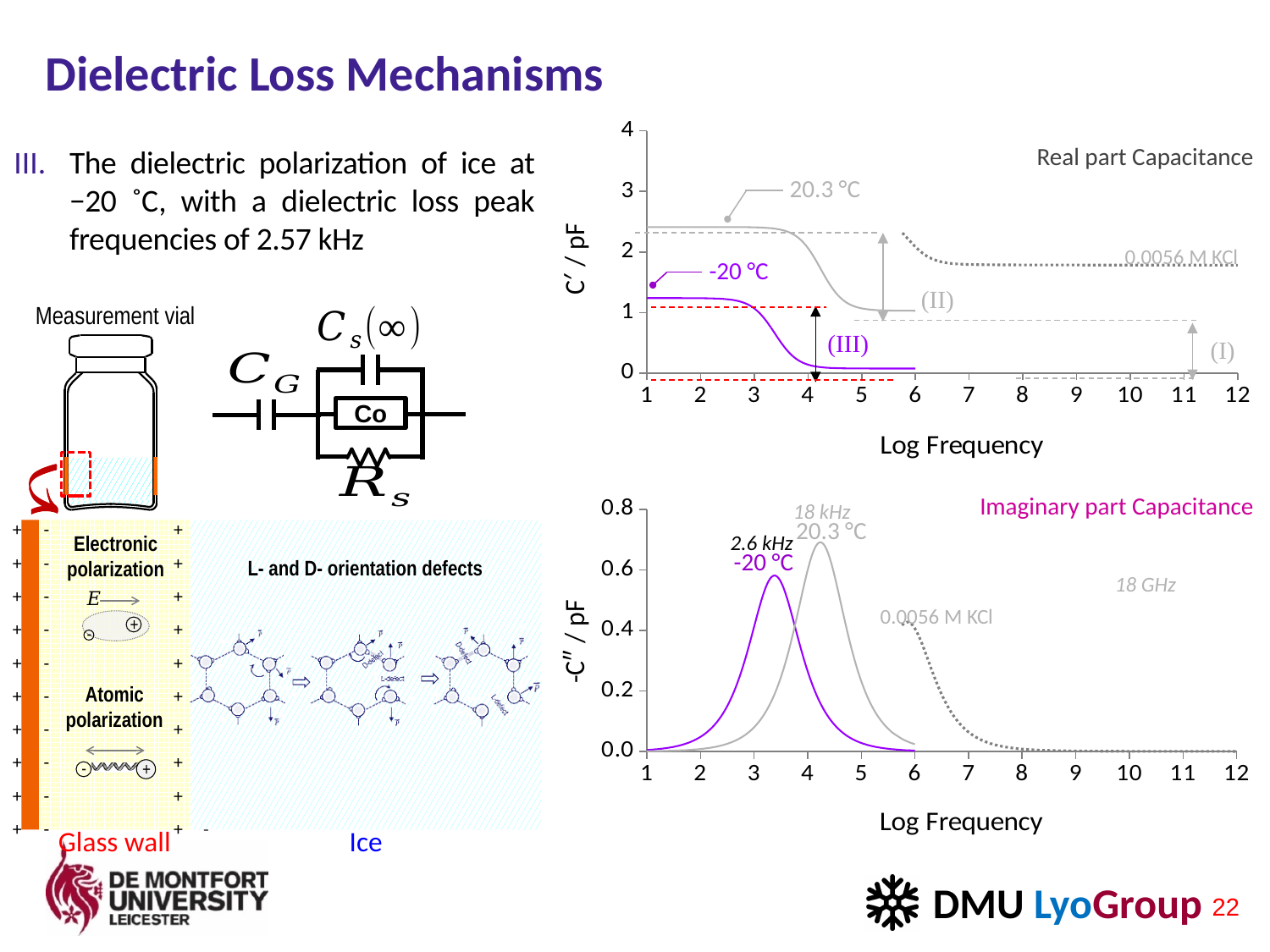
What is the y-axis label of the Real part Capacitance chart? C′ / pF What is the x-axis label of the Imaginary part Capacitance chart? Log Frequency What kind of chart is the Real part Capacitance chart? line chart In the Imaginary part Capacitance chart, which curve has the higher peak, -20 °C or 20.3 °C? 20.3 °C In the Imaginary part Capacitance chart, is the value of the 0.0056 M KCl curve at Log Frequency 8 greater or less than 0.2? less In the Imaginary part Capacitance chart, what peak frequency is labelled for the -20 °C curve? 2.6 kHz In the Real part Capacitance chart, is the value of the -20 °C curve at Log Frequency 6 greater or less than 1? less In the Imaginary part Capacitance chart, is the peak value of the -20 °C curve greater or less than 0.4? greater In the Imaginary part Capacitance chart, what peak frequency is labelled for the 20.3 °C curve? 18 kHz In the Real part Capacitance chart, does the 20.3 °C curve rise or fall as Log Frequency increases? fall